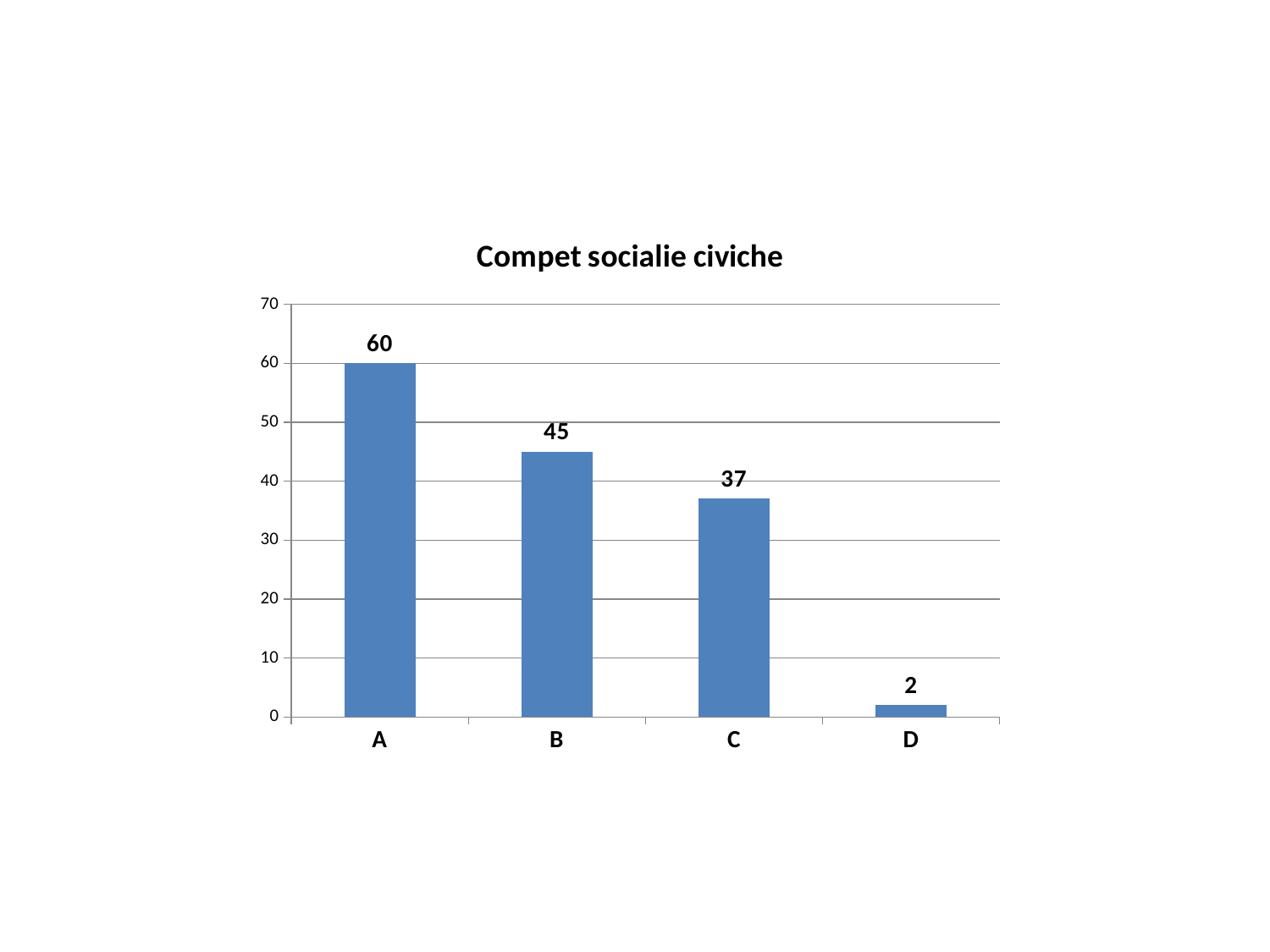
Which category has the highest value? A Which is larger, the value for B or the value for C? B What kind of chart is shown? bar chart What is the difference between the values for B and C? 8 What is the difference between the values for A and B? 15 What is the value for category C? 37 How many categories are shown on the x axis? 4 What is the value for category D? 2 Is the value for C greater or less than 40? less What is the value for category A? 60 Which category has the lowest value? D What is the title of the chart? Compet socialie civiche